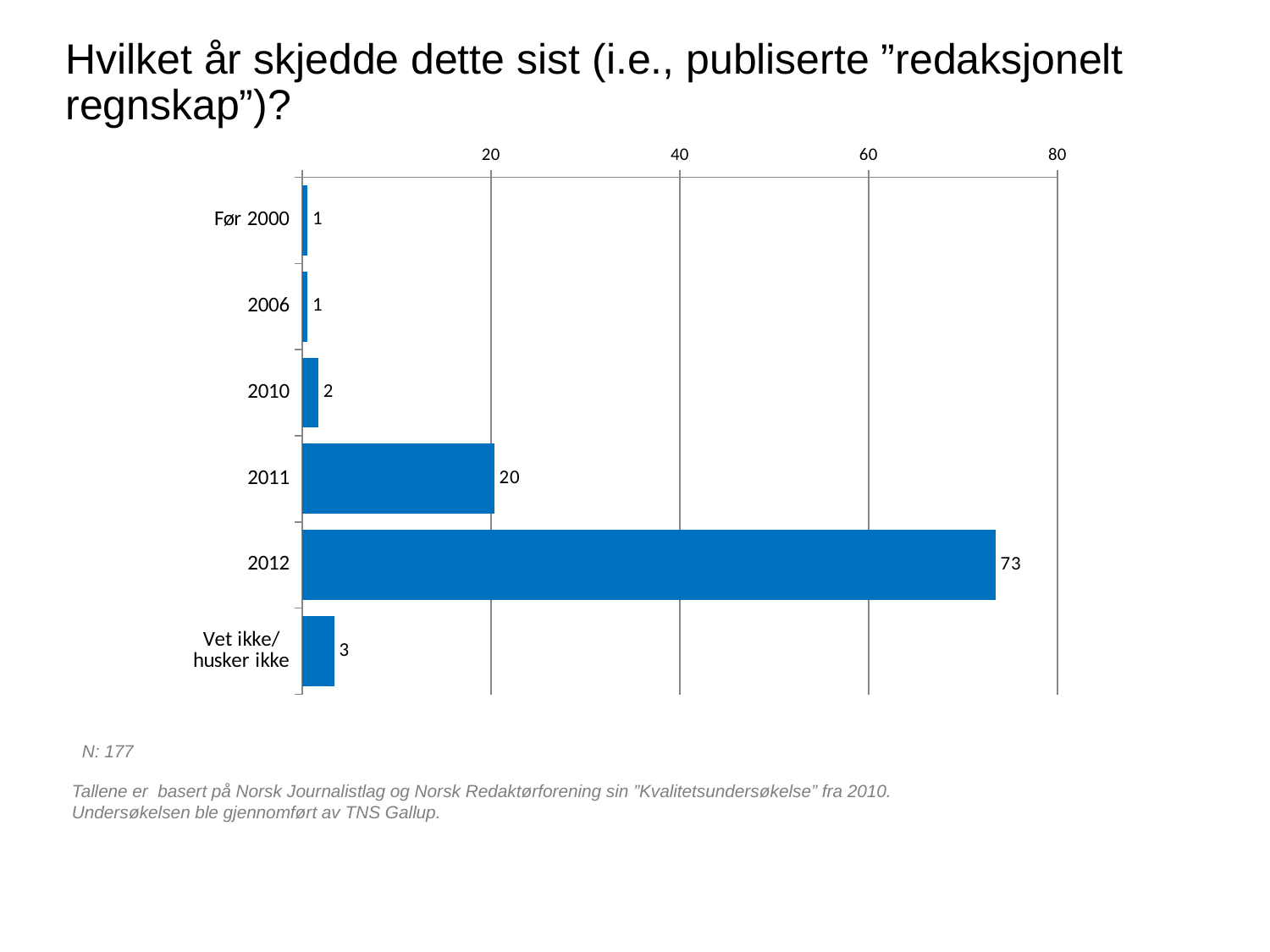
Which category has the highest value? 2012 What is the value for 2011? 20 What is the value for 2010? 2 How many categories are shown in the chart? 6 Is the value for 2012 greater or less than 60? greater What is the difference between the values for 2012 and 2011? 53 What is the value for 2012? 73 What is the value for 'Før 2000'? 1 What kind of chart is shown on the slide? bar chart Which is larger, the value for 2011 or the value for 'Vet ikke/husker ikke'? 2011 What is the sample size (N) stated below the chart? 177 What is the value for 'Vet ikke/husker ikke'? 3